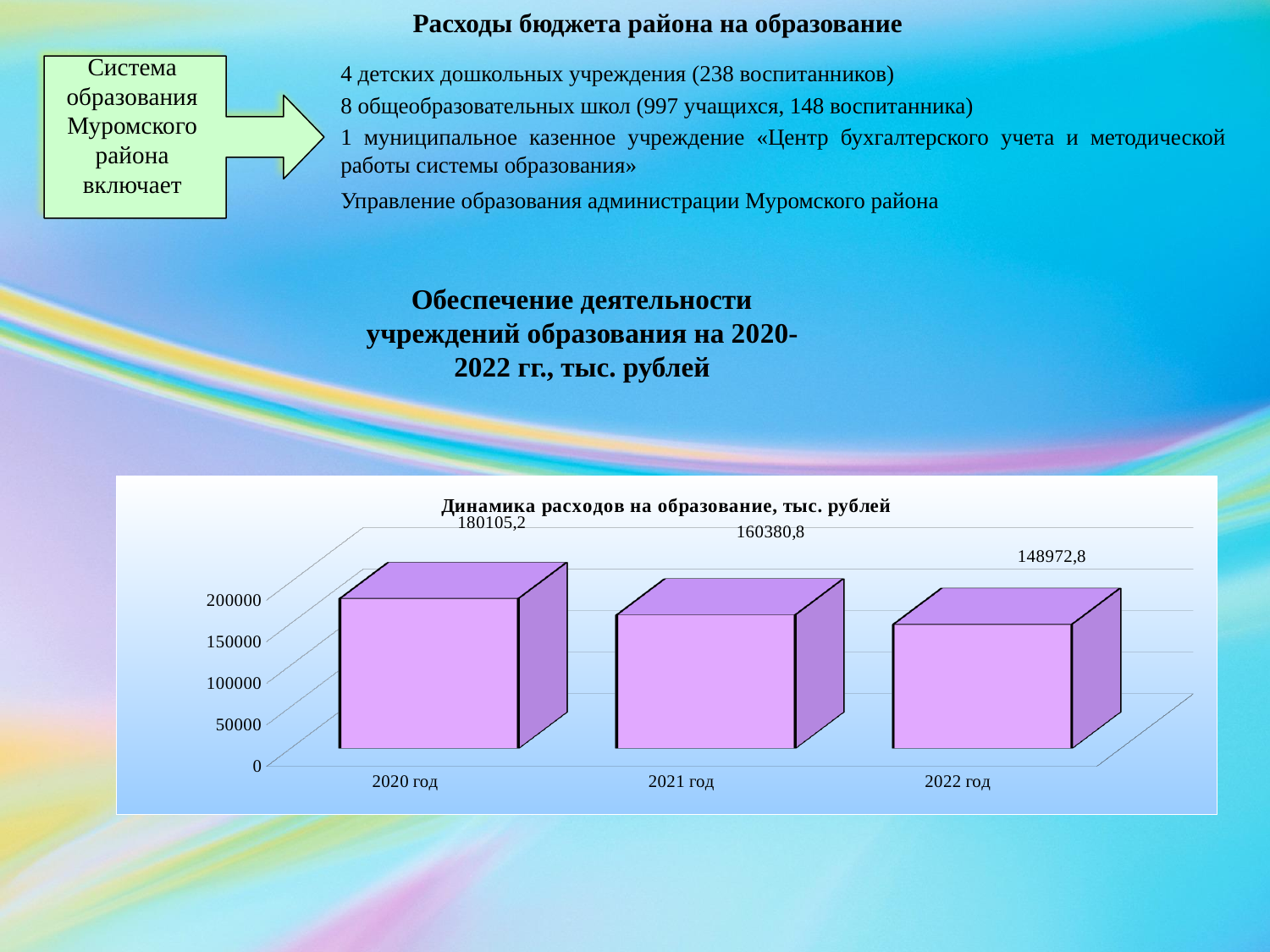
What is the difference between the values for 2021 год and 2022 год? 11408 What is the value for 2020 год in the chart 'Динамика расходов на образование, тыс. рублей'? 180105,2 Which year has the highest value in the chart? 2020 год What is the value for 2022 год in the chart? 148972,8 Which is larger, the value for 2021 год or the value for 2022 год? 2021 год How many years are shown on the x axis of the chart? 3 Do the values rise or fall from 2020 год to 2022 год? fall Is the value for 2021 год greater or less than 150000? greater What is the value for 2021 год in the chart? 160380,8 Which year has the lowest value in the chart? 2022 год What is the difference between the values for 2020 год and 2021 год? 19724,4 What kind of chart is shown on the slide? bar chart